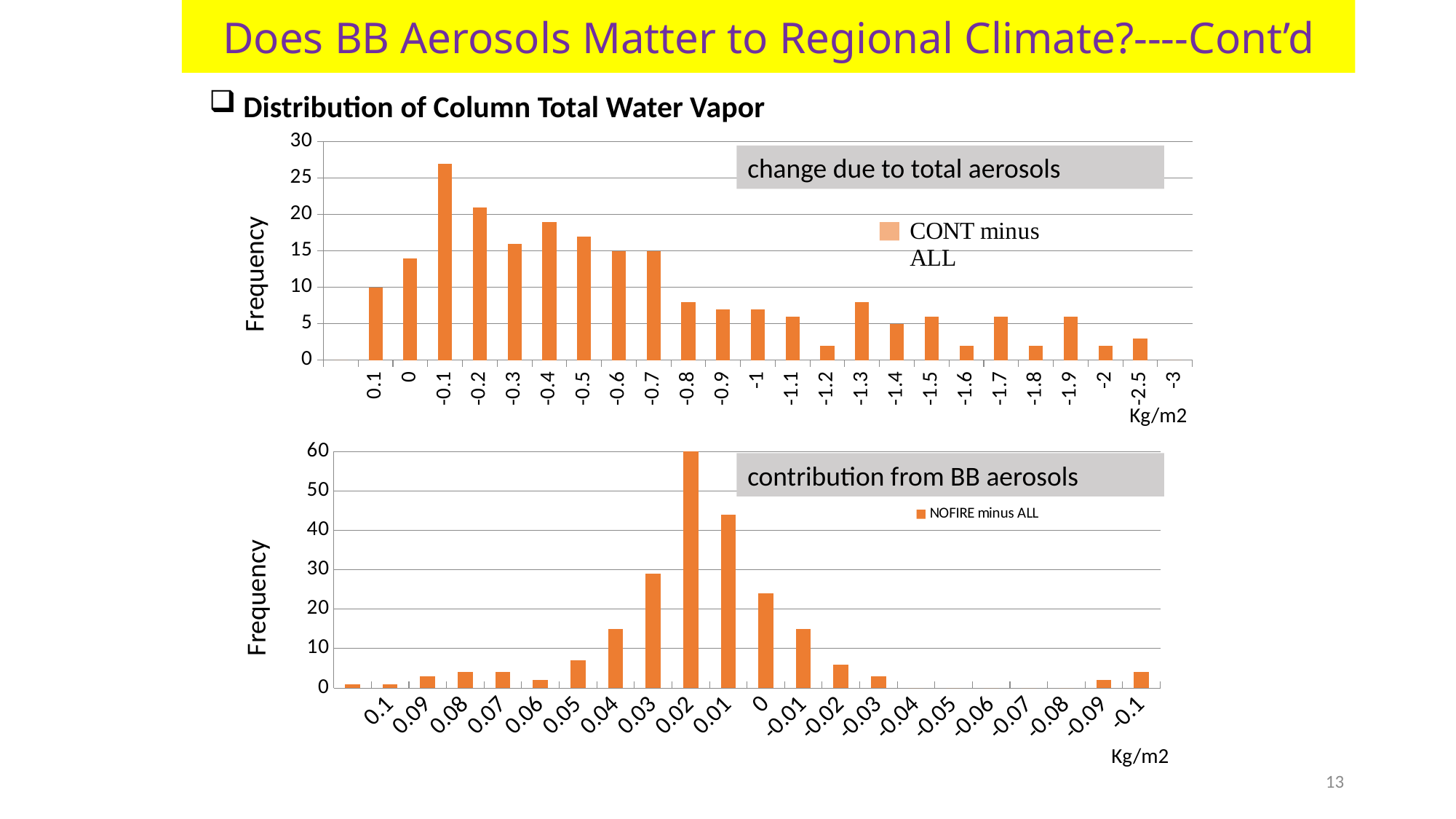
In the top chart (change due to total aerosols), what is the frequency for the -0.6 category? 15 In the top chart (change due to total aerosols), which category has the highest frequency? -0.1 In the top chart (change due to total aerosols), is the value for -0.1 greater or less than 25? greater In the bottom chart (contribution from BB aerosols), how many categories are shown on the x axis? 21 In the bottom chart (contribution from BB aerosols), which category has the highest frequency? 0.02 In the bottom chart (contribution from BB aerosols), is the value for 0.01 greater or less than 40? greater In the top chart (change due to total aerosols), which has a higher frequency, -0.1 or -0.2? -0.1 In the bottom chart (contribution from BB aerosols), what is the frequency for the 0.02 category? 60 What kind of chart is the top chart (change due to total aerosols)? bar chart What is the legend entry of the bottom chart (contribution from BB aerosols)? NOFIRE minus ALL In the top chart (change due to total aerosols), what is the frequency for the 0.1 category? 10